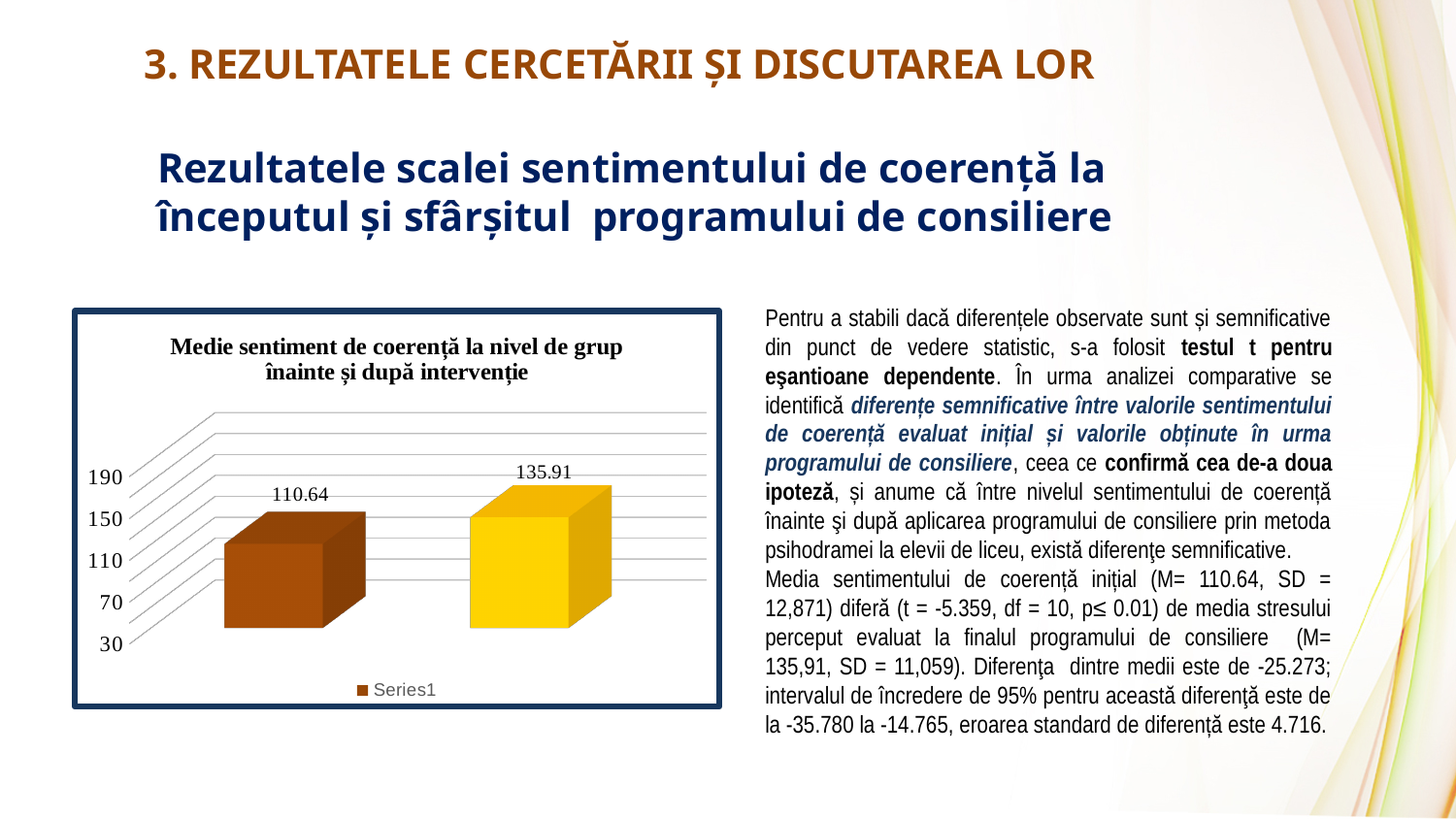
What is the value shown on the right (yellow) bar of the chart? 135.91 What is the name of the series shown in the chart legend? Series1 What is the value shown on the left (brown) bar of the chart? 110.64 Do the bar values rise or fall from left to right in the chart? rise Is the value of the right (yellow) bar greater or less than 110? greater How many bars are plotted in the chart? 2 Is the value of the left (brown) bar greater or less than 150? less What type of chart is shown on the slide? bar chart How many series does the chart legend list? 1 What is the title of the chart? Medie sentiment de coerență la nivel de grup înainte și după intervenție Which bar has the higher value, the left (brown) bar or the right (yellow) bar? the right (yellow) bar What is the difference between the values of the two bars in the chart? 25.27